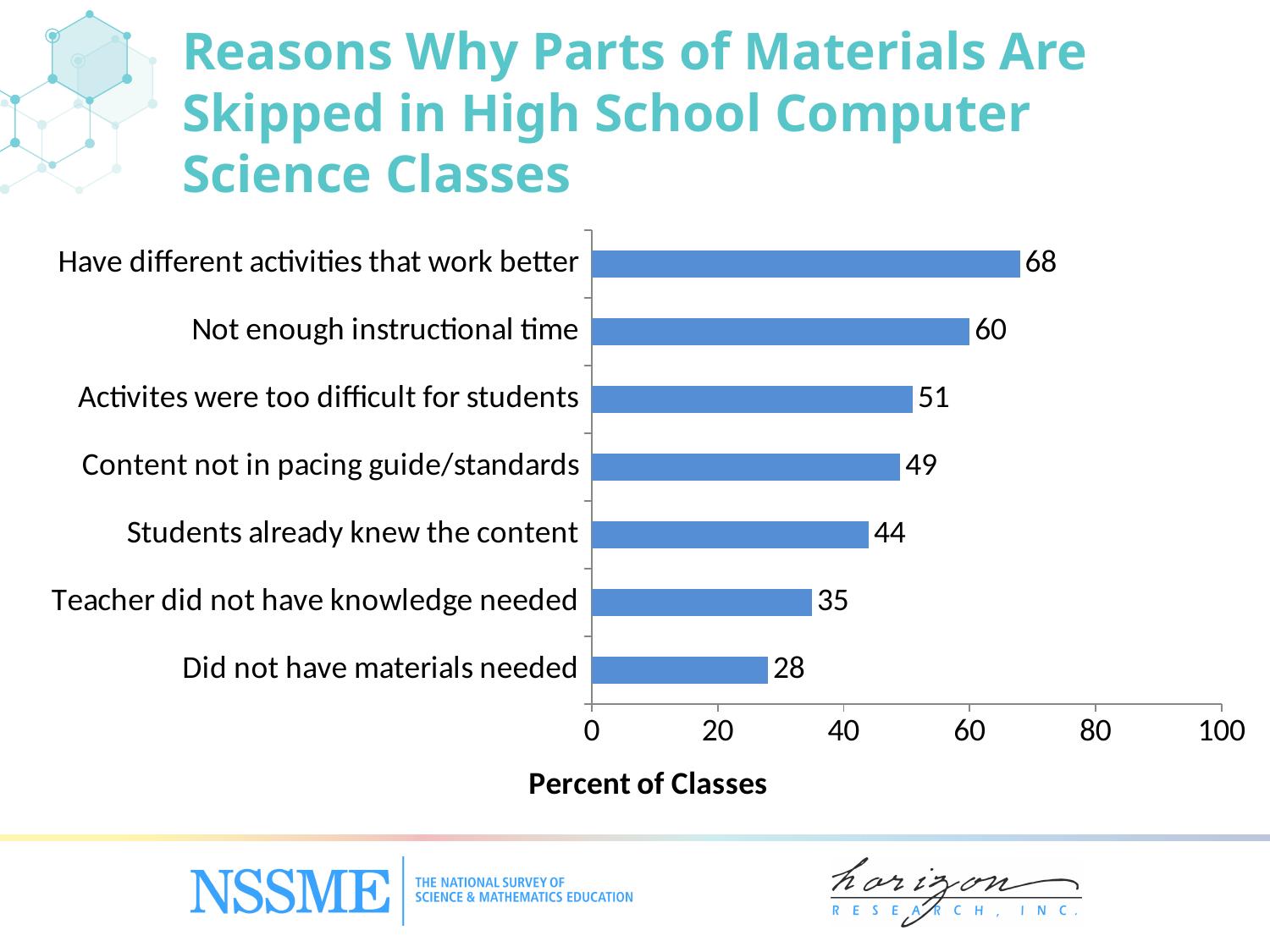
What is the label of the horizontal axis? Percent of Classes What is the value for "Not enough instructional time"? 60 Which reason has the lowest percent of classes? Did not have materials needed What is the difference between the values for "Not enough instructional time" and "Did not have materials needed"? 32 What percent of classes cited "Teacher did not have knowledge needed"? 35 What kind of chart is shown on the slide? Bar chart Which is larger: the value for "Students already knew the content" or "Teacher did not have knowledge needed"? Students already knew the content Which reason has the highest percent of classes? Have different activities that work better What percent of classes skipped parts of materials because they have different activities that work better? 68 What is the difference between the values for "Activites were too difficult for students" and "Content not in pacing guide/standards"? 2 How many reasons are shown in the chart? 7 Is the value for "Content not in pacing guide/standards" greater or less than 40? greater